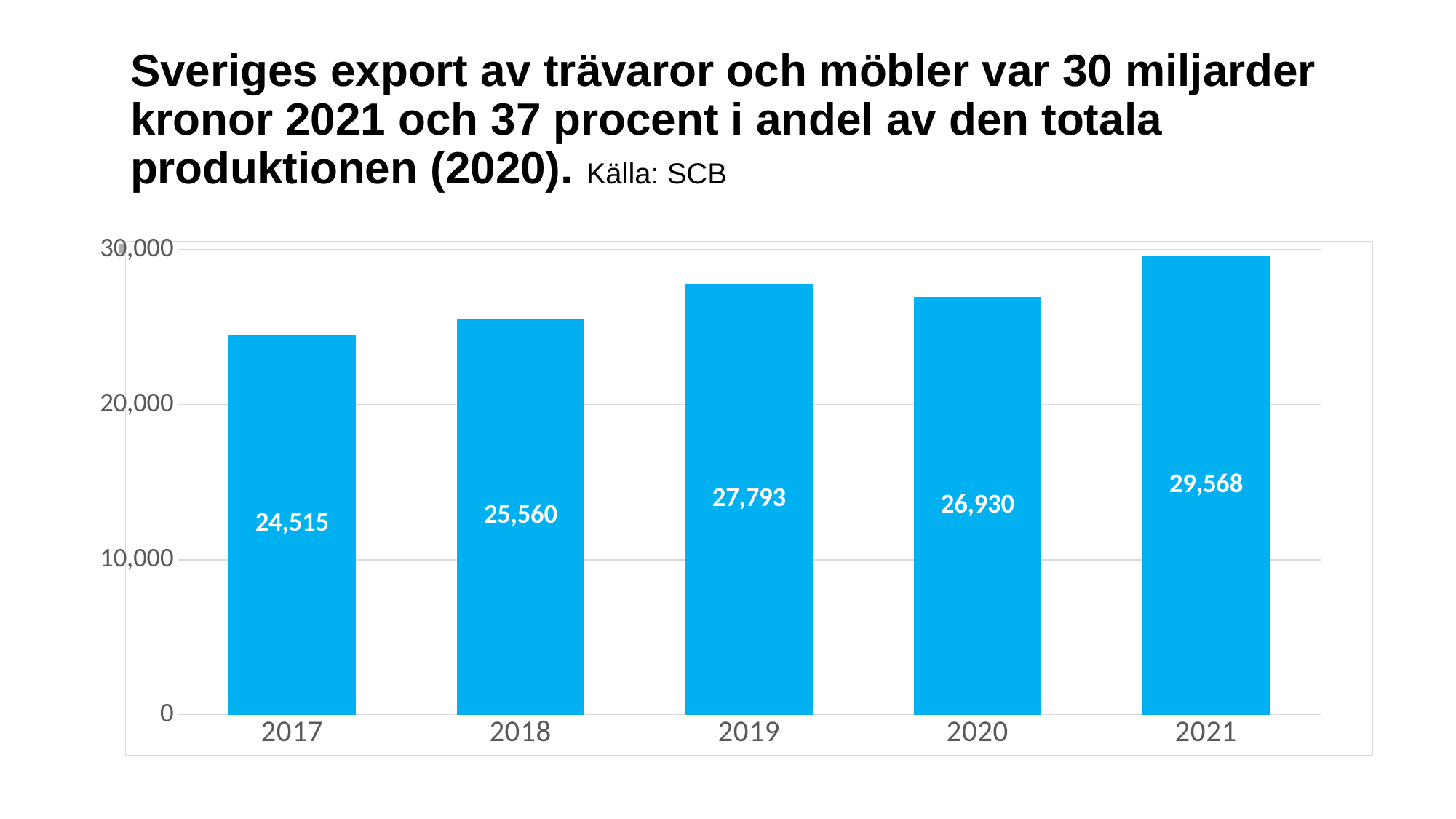
What kind of chart is shown on the slide? Bar chart Which is larger, the value for 2018 or the value for 2020? 2020 What is the value for 2019? 27,793 What is the difference between the values for 2019 and 2020? 863 What is the difference between the values for 2021 and 2017? 5,053 Which year has the lowest value? 2017 Is the value for 2020 greater or less than 20,000? greater What is the value for 2021? 29,568 What source is cited for the chart data? SCB How many years are shown on the x axis? 5 Which year has the highest value? 2021 What is the value for 2017? 24,515